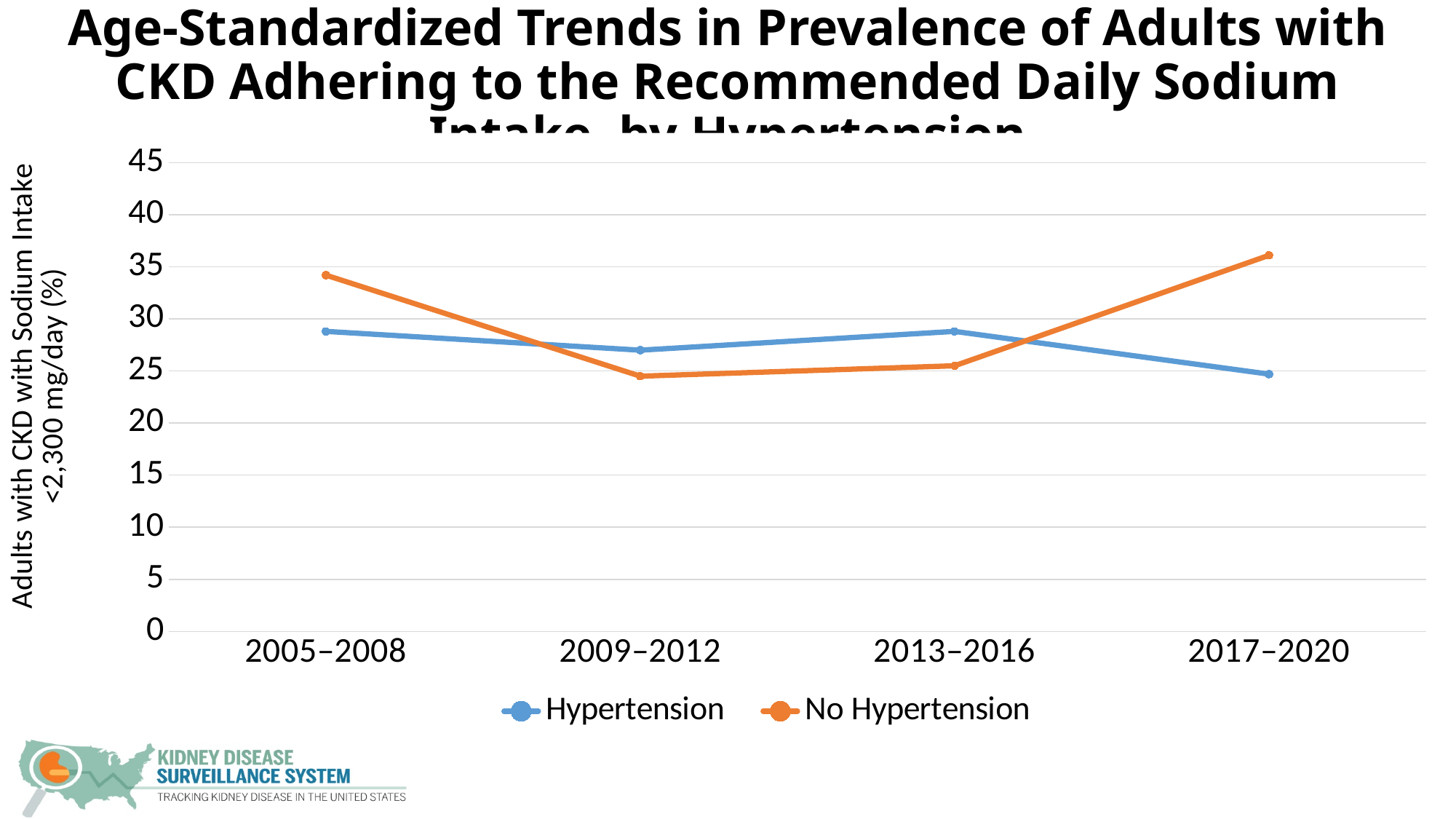
Is the value for No Hypertension in 2005–2008 greater or less than 30? greater Is the value for No Hypertension in 2009–2012 greater or less than 30? less Which series is drawn in orange? No Hypertension What kind of chart is shown on the slide? Line chart Is the value for Hypertension in 2017–2020 greater or less than 30? less In which period is the Hypertension series at its lowest? 2017–2020 How many time periods are plotted along the x axis? 4 Does the No Hypertension series rise or fall from 2013–2016 to 2017–2020? Rise In 2013–2016, which series has the higher value, Hypertension or No Hypertension? Hypertension How many series does the legend list? 2 In 2017–2020, which series has the higher value, Hypertension or No Hypertension? No Hypertension